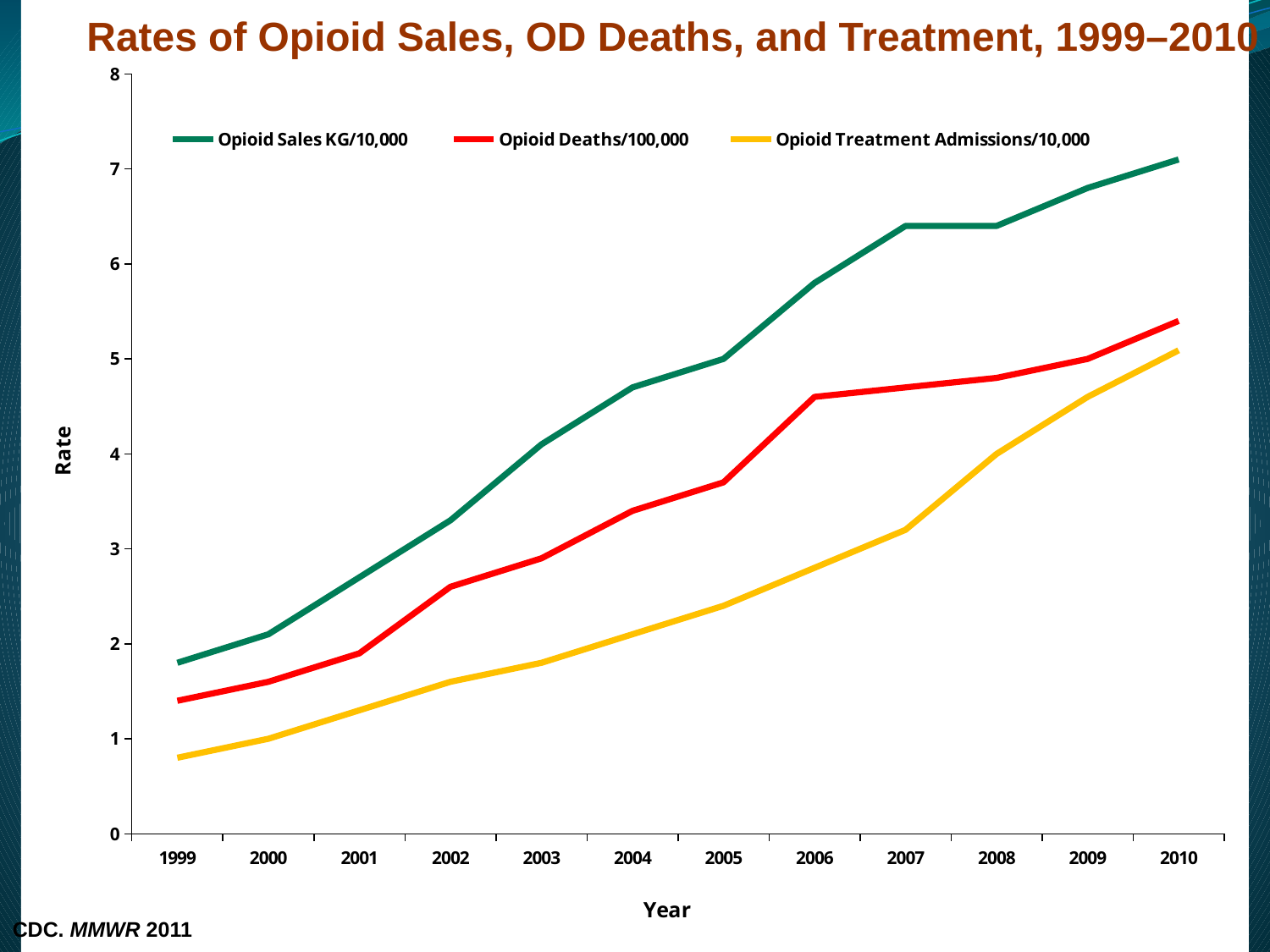
Which series has the highest value in 2010? Opioid Sales KG/10,000 Is the value for Opioid Sales KG/10,000 in 2010 greater or less than 7? greater Is the value for Opioid Deaths/100,000 in 2006 greater or less than 4? greater Is the value for Opioid Treatment Admissions/10,000 in 1999 greater or less than 1? less Do the Opioid Sales KG/10,000 values rise or fall from 1999 to 2010? rise Which series is drawn in red? Opioid Deaths/100,000 How many years are shown along the x axis? 12 How many series does the legend list? 3 What is the title of the chart? Rates of Opioid Sales, OD Deaths, and Treatment, 1999–2010 In 2008, which is larger: Opioid Deaths/100,000 or Opioid Treatment Admissions/10,000? Opioid Deaths/100,000 Which series has the lowest value in 1999? Opioid Treatment Admissions/10,000 What kind of chart is shown on the slide? line chart